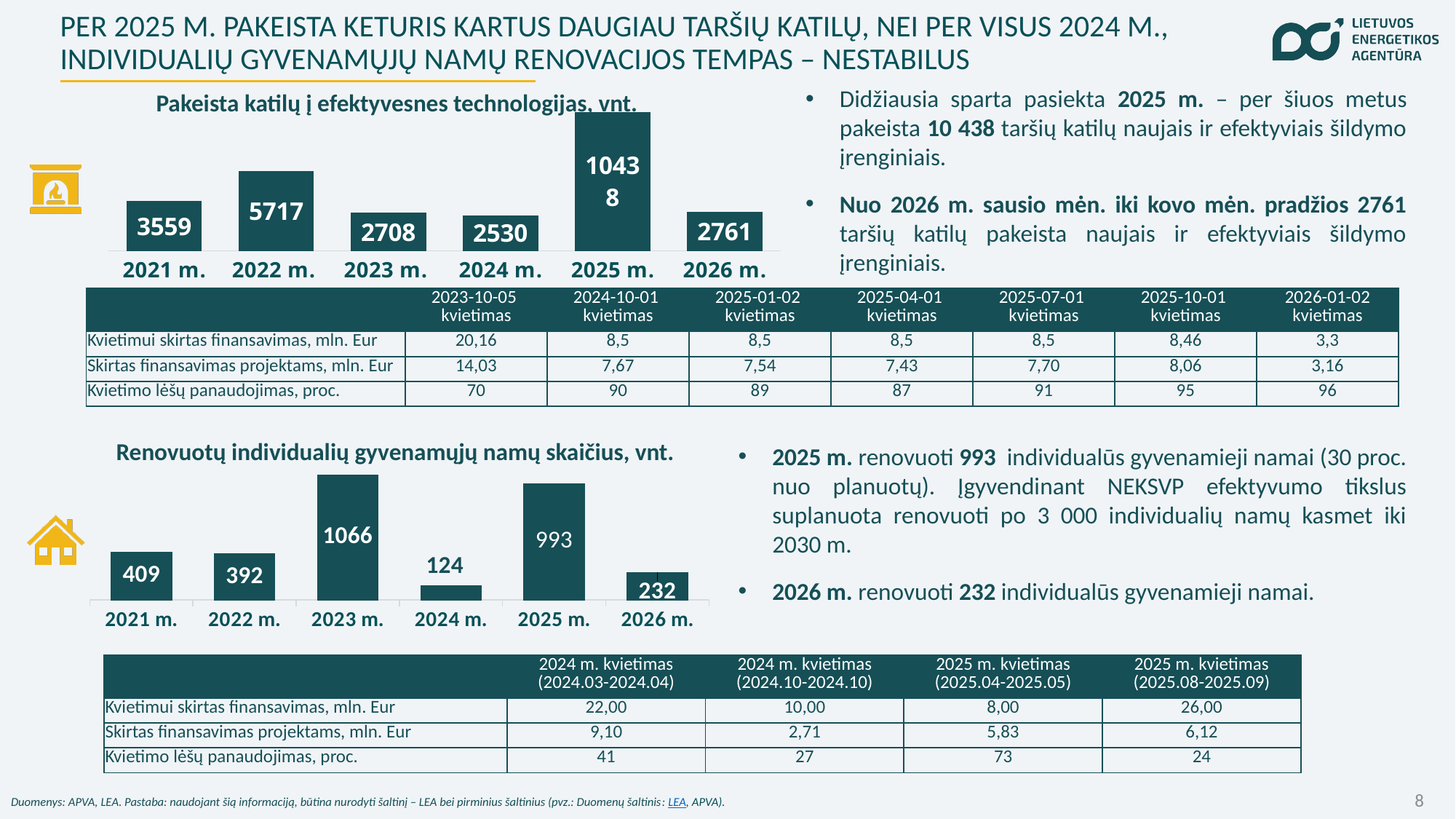
In the chart 'Pakeista katilų į efektyvesnes technologijas, vnt.', which year has the lowest value? 2024 m. In the chart 'Renovuotų individualių gyvenamųjų namų skaičius, vnt.', what is the value for 2023 m.? 1066 In the chart 'Renovuotų individualių gyvenamųjų namų skaičius, vnt.', what is the difference between the values for 2025 m. and 2026 m.? 761 In the chart 'Pakeista katilų į efektyvesnes technologijas, vnt.', what is the difference between the values for 2025 m. and 2024 m.? 7908 In the chart 'Renovuotų individualių gyvenamųjų namų skaičius, vnt.', what is the value for 2024 m.? 124 In the chart 'Pakeista katilų į efektyvesnes technologijas, vnt.', what is the value for 2025 m.? 10438 How many bars are shown in the chart 'Pakeista katilų į efektyvesnes technologijas, vnt.'? 6 In the chart 'Pakeista katilų į efektyvesnes technologijas, vnt.', which is larger, the value for 2021 m. or 2023 m.? 2021 m. What type of chart is 'Renovuotų individualių gyvenamųjų namų skaičius, vnt.'? Bar chart In the chart 'Pakeista katilų į efektyvesnes technologijas, vnt.', what is the value for 2022 m.? 5717 In the chart 'Renovuotų individualių gyvenamųjų namų skaičius, vnt.', which is larger, the value for 2021 m. or 2022 m.? 2021 m. In the chart 'Renovuotų individualių gyvenamųjų namų skaičius, vnt.', which year has the highest value? 2023 m.